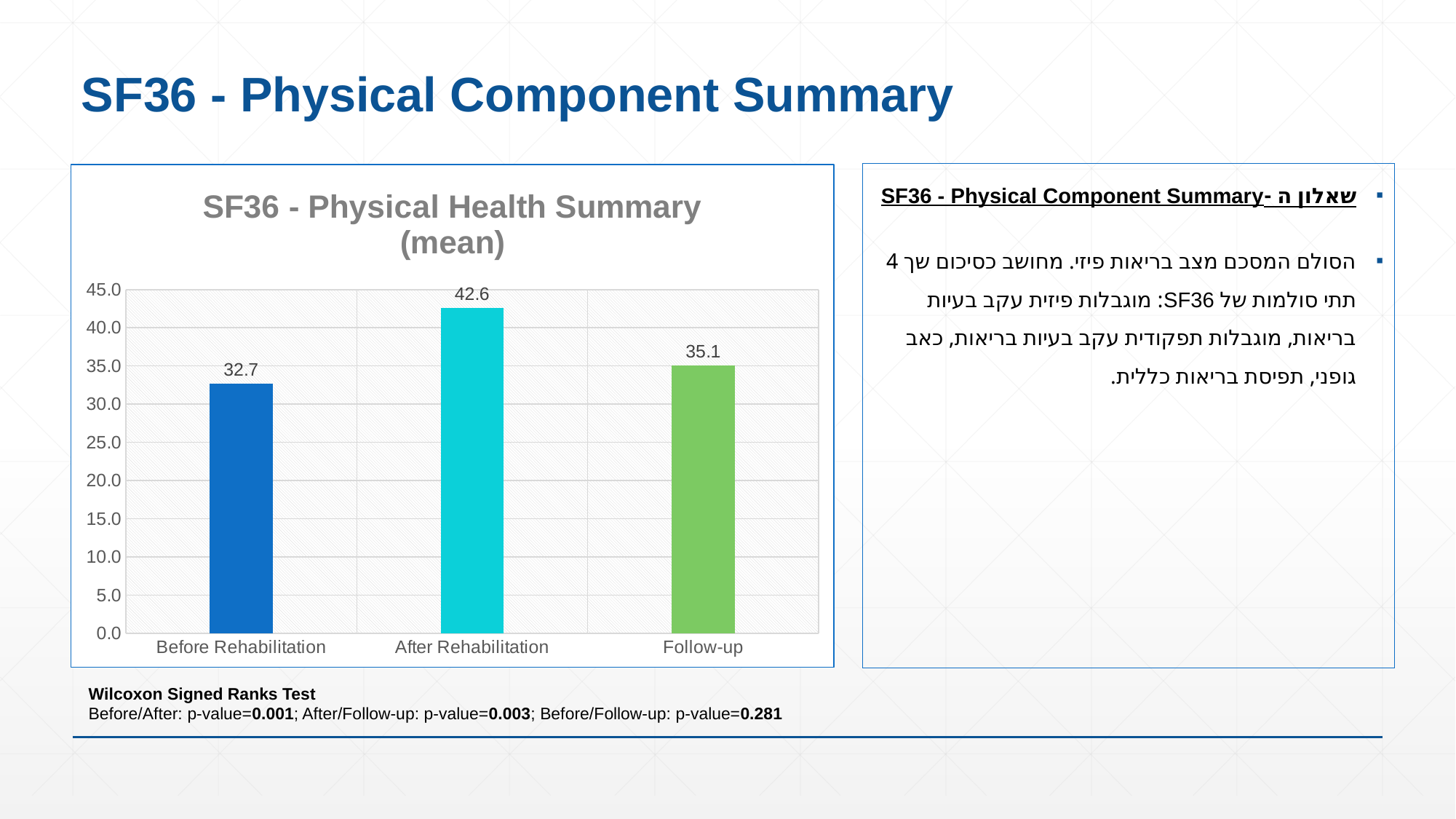
What is the value for After Rehabilitation? 42.6 Which is larger, the value for Follow-up or the value for Before Rehabilitation? Follow-up What kind of chart is shown on the slide? bar chart Which category has the lowest value? Before Rehabilitation What is the title of the chart? SF36 - Physical Health Summary (mean) How many categories are shown on the x axis? 3 What is the value for Before Rehabilitation? 32.7 What is the difference between the After Rehabilitation and Follow-up values? 7.5 What is the value for Follow-up? 35.1 What is the difference between the After Rehabilitation and Before Rehabilitation values? 9.9 Is the value for After Rehabilitation greater or less than 40.0? greater Which category has the highest value? After Rehabilitation